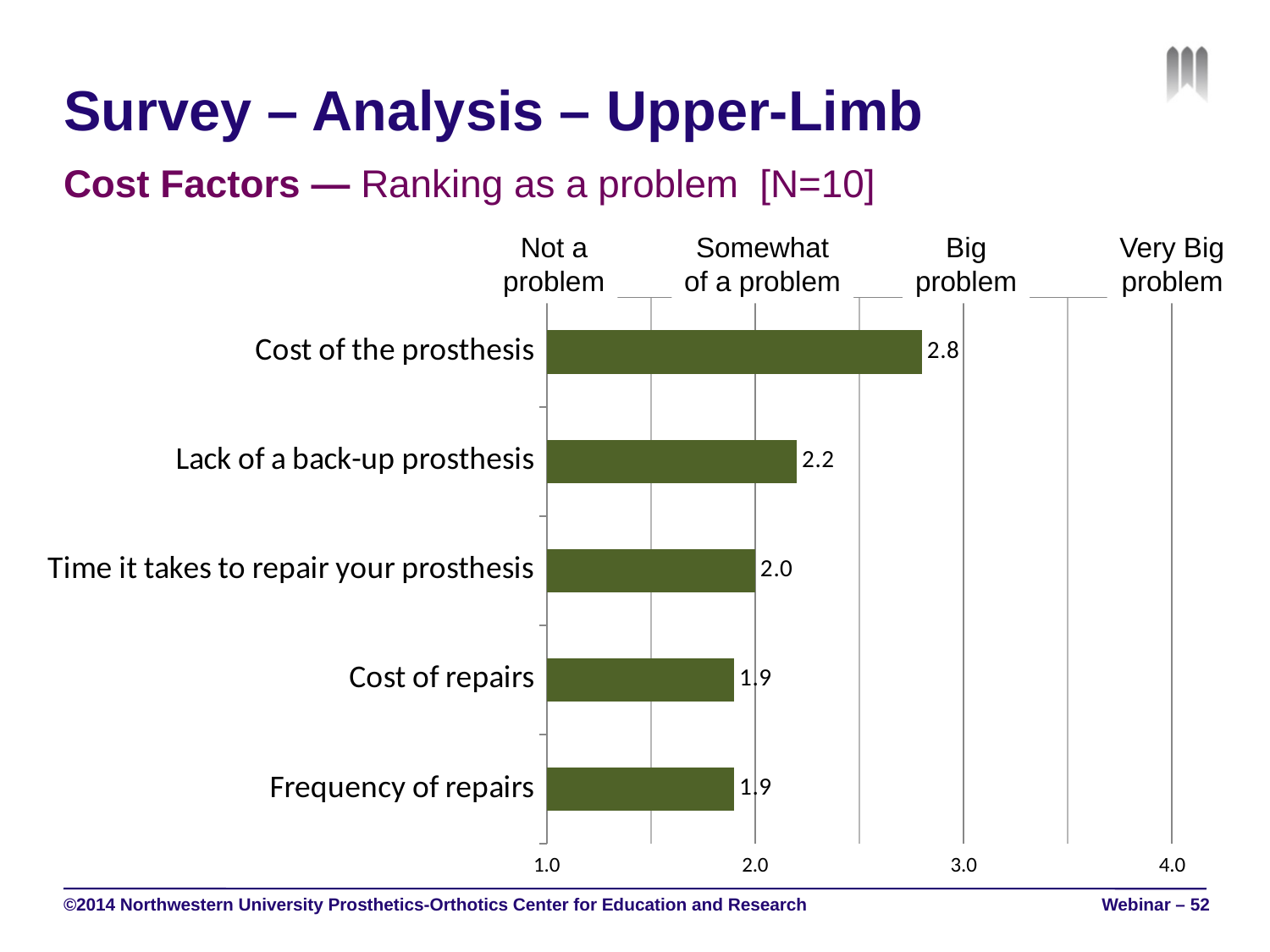
What is the difference between the values for Time it takes to repair your prosthesis and Frequency of repairs? 0.1 Which cost factor has the highest value? Cost of the prosthesis Is the value for Cost of the prosthesis greater or less than 3.0? less Which is larger, the value for Lack of a back-up prosthesis or the value for Time it takes to repair your prosthesis? Lack of a back-up prosthesis What is the value for Cost of the prosthesis? 2.8 What is the difference between the values for Cost of the prosthesis and Lack of a back-up prosthesis? 0.6 What is the value for Cost of repairs? 1.9 What label on the scale corresponds to the value 3.0? Big problem How many cost factors are shown in the chart? 5 What kind of chart is shown on the slide? bar chart What is the value for Lack of a back-up prosthesis? 2.2 What is the value for Time it takes to repair your prosthesis? 2.0